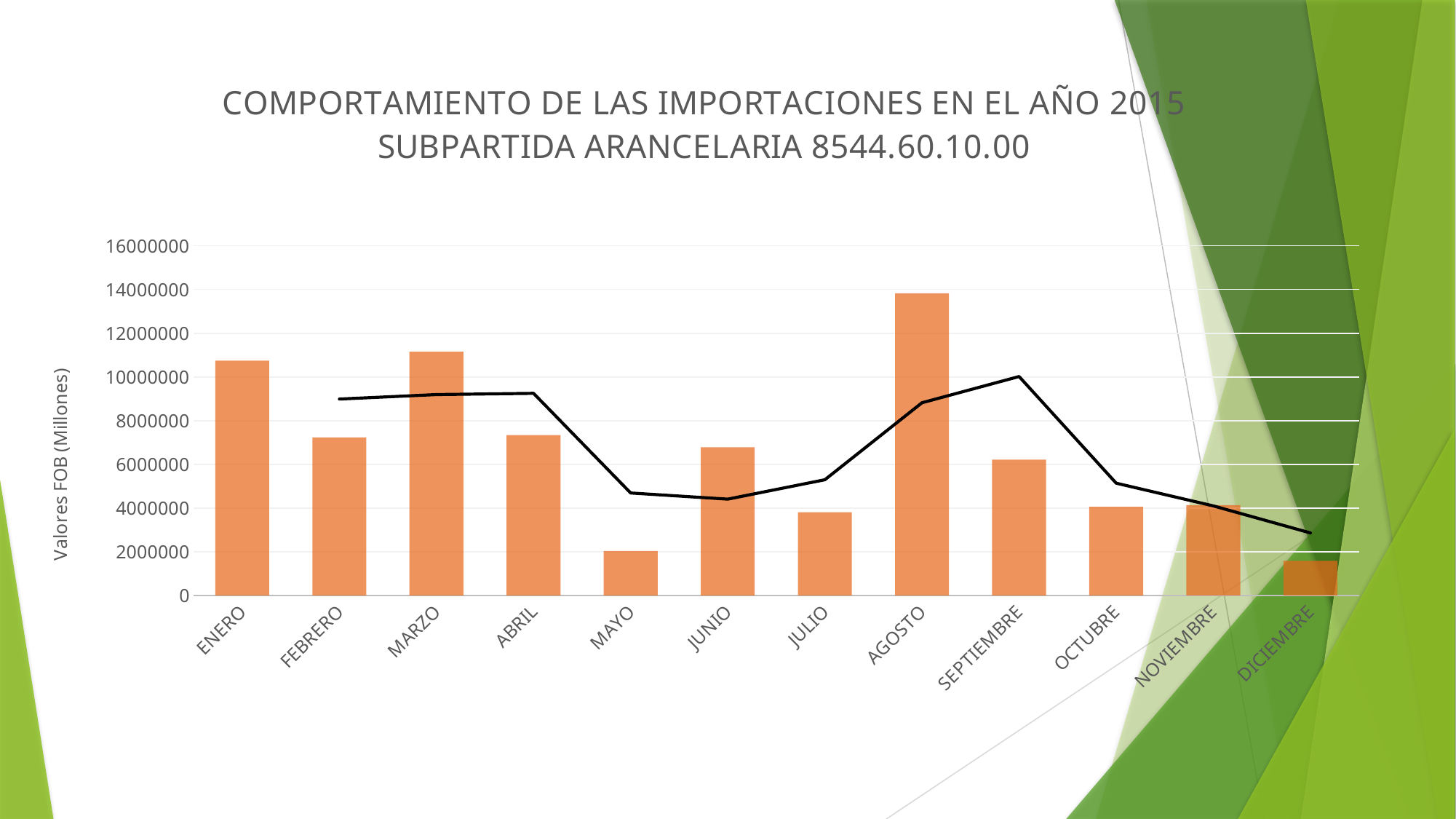
Which bar is taller, SEPTIEMBRE or AGOSTO? AGOSTO How many months are shown on the x axis of the chart? 12 What is the title of the chart? COMPORTAMIENTO DE LAS IMPORTACIONES EN EL AÑO 2015 SUBPARTIDA ARANCELARIA 8544.60.10.00 Which month has the lowest bar in the chart? DICIEMBRE Which bar is taller, JUNIO or OCTUBRE? JUNIO Is the bar for MAYO greater or less than 4000000? less Which month has the highest bar in the chart? AGOSTO Is the bar for MARZO greater or less than 10000000? greater Which bar is taller, ENERO or FEBRERO? ENERO Is the bar for AGOSTO greater or less than 12000000? greater What is the label of the vertical axis? Valores FOB (Millones)